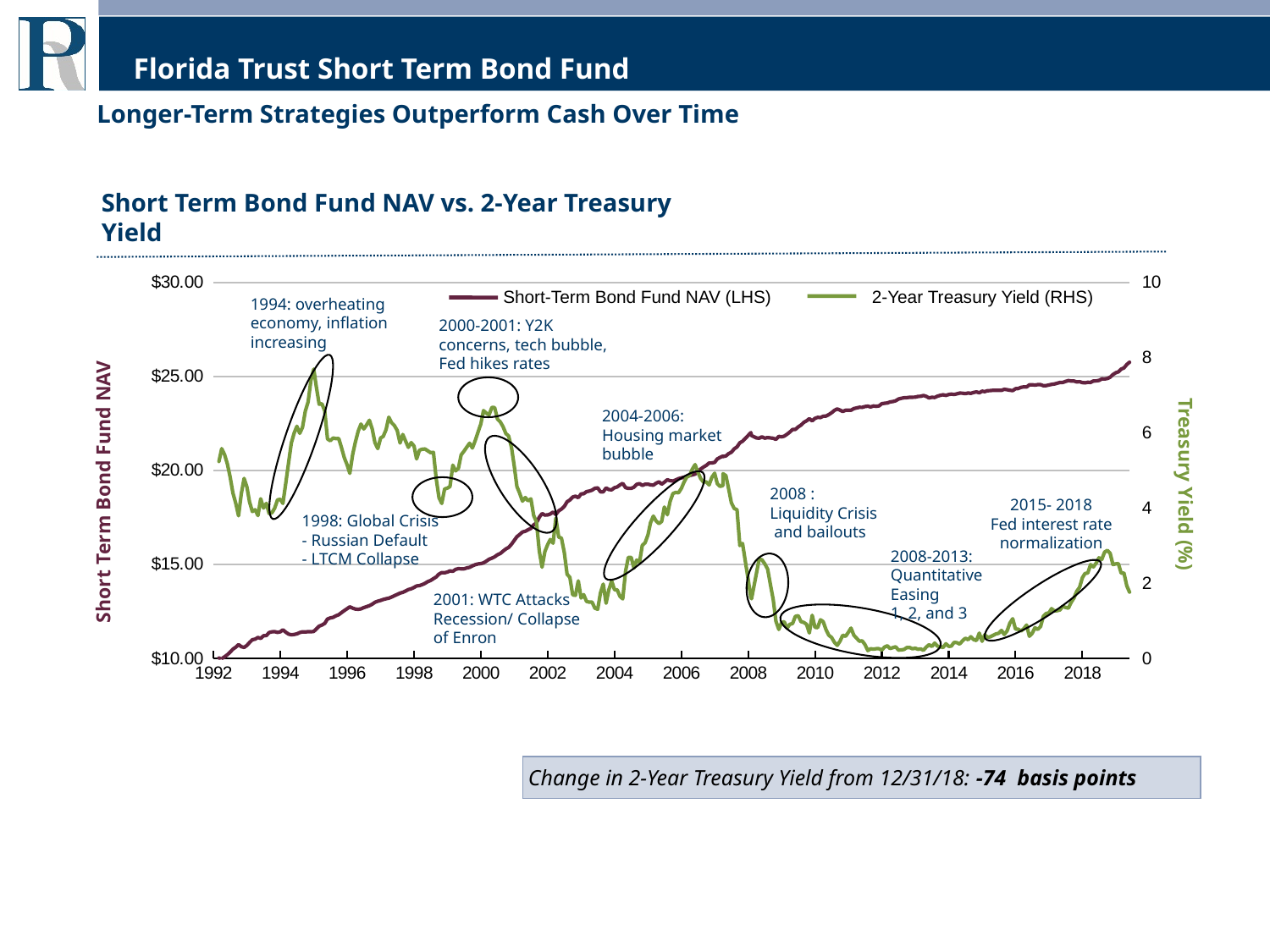
Is the 2-Year Treasury Yield at its 2000 peak greater or less than 6? greater What is the label of the right-hand vertical axis? Treasury Yield (%) Does the Short-Term Bond Fund NAV rise or fall from 1992 to 2018? Rise Is the Short-Term Bond Fund NAV in 2000 greater or less than $20.00? less Does the 2-Year Treasury Yield rise or fall from 2007 to 2012? Fall Is the 2-Year Treasury Yield in 2012 greater or less than 2? less What is the title of the chart? Short Term Bond Fund NAV vs. 2-Year Treasury Yield How many series does the chart legend list? 2 Which is larger, the Short-Term Bond Fund NAV in 1992 or in 2018? 2018 What kind of chart is shown on the slide? Line chart Which is larger, the 2-Year Treasury Yield in 2000 or in 2012? 2000